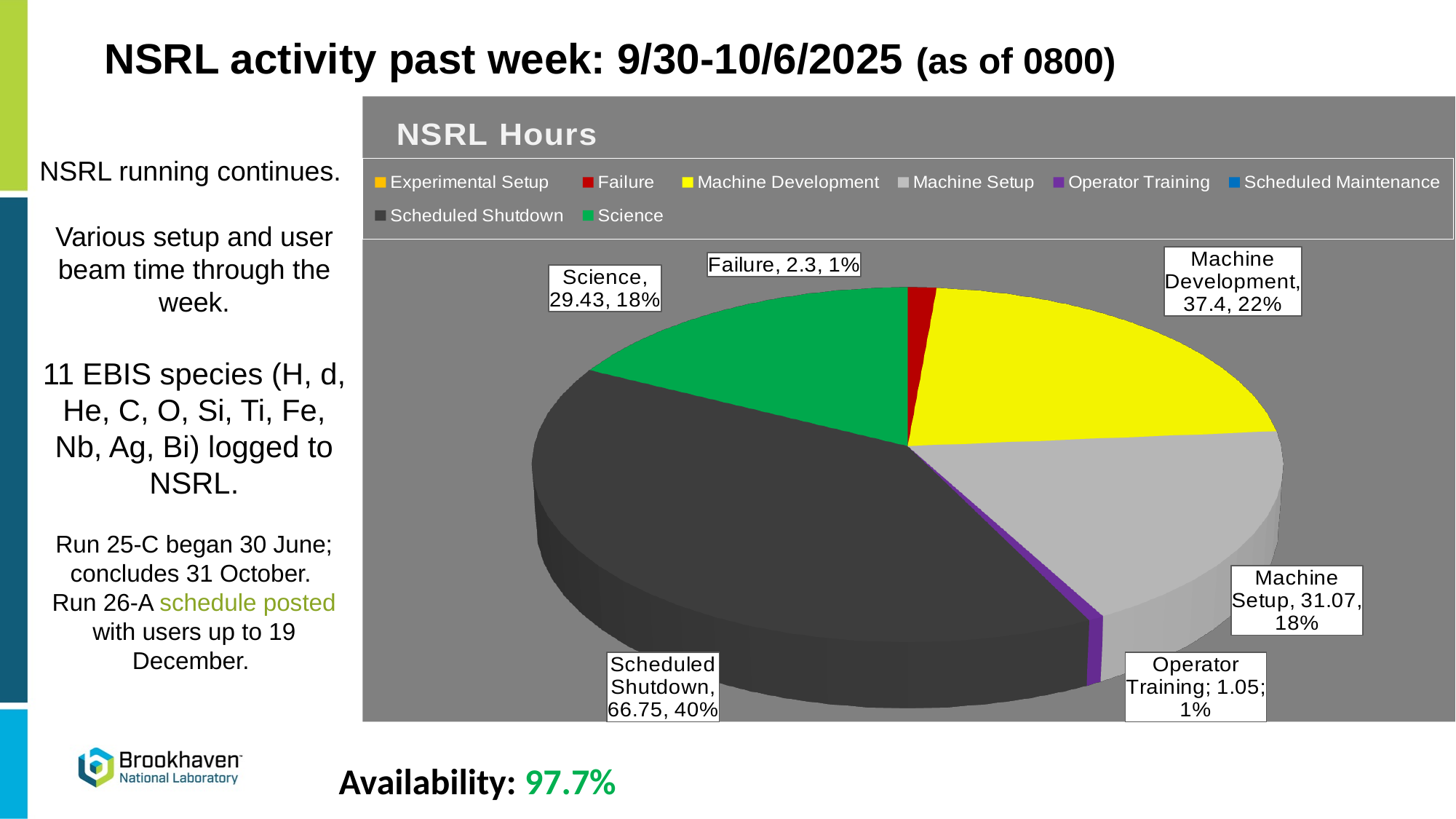
What kind of chart is shown on the slide? pie chart What is the title of the chart? NSRL Hours What share of the pie does Scheduled Shutdown take in the NSRL Hours chart? 40% Which category has the largest slice in the NSRL Hours chart? Scheduled Shutdown How many hours are labelled for Operator Training in the NSRL Hours chart? 1.05 Which has more hours in the NSRL Hours chart, Machine Setup or Science? Machine Setup How many hours are labelled for Machine Development in the NSRL Hours chart? 37.4 Which labelled category has the smallest slice in the NSRL Hours chart? Operator Training What is the difference in hours between Machine Development and Machine Setup in the NSRL Hours chart? 6.33 How many hours are labelled for Science in the NSRL Hours chart? 29.43 How many entries does the legend of the NSRL Hours chart list? 8 How many hours are labelled for Scheduled Shutdown in the NSRL Hours chart? 66.75